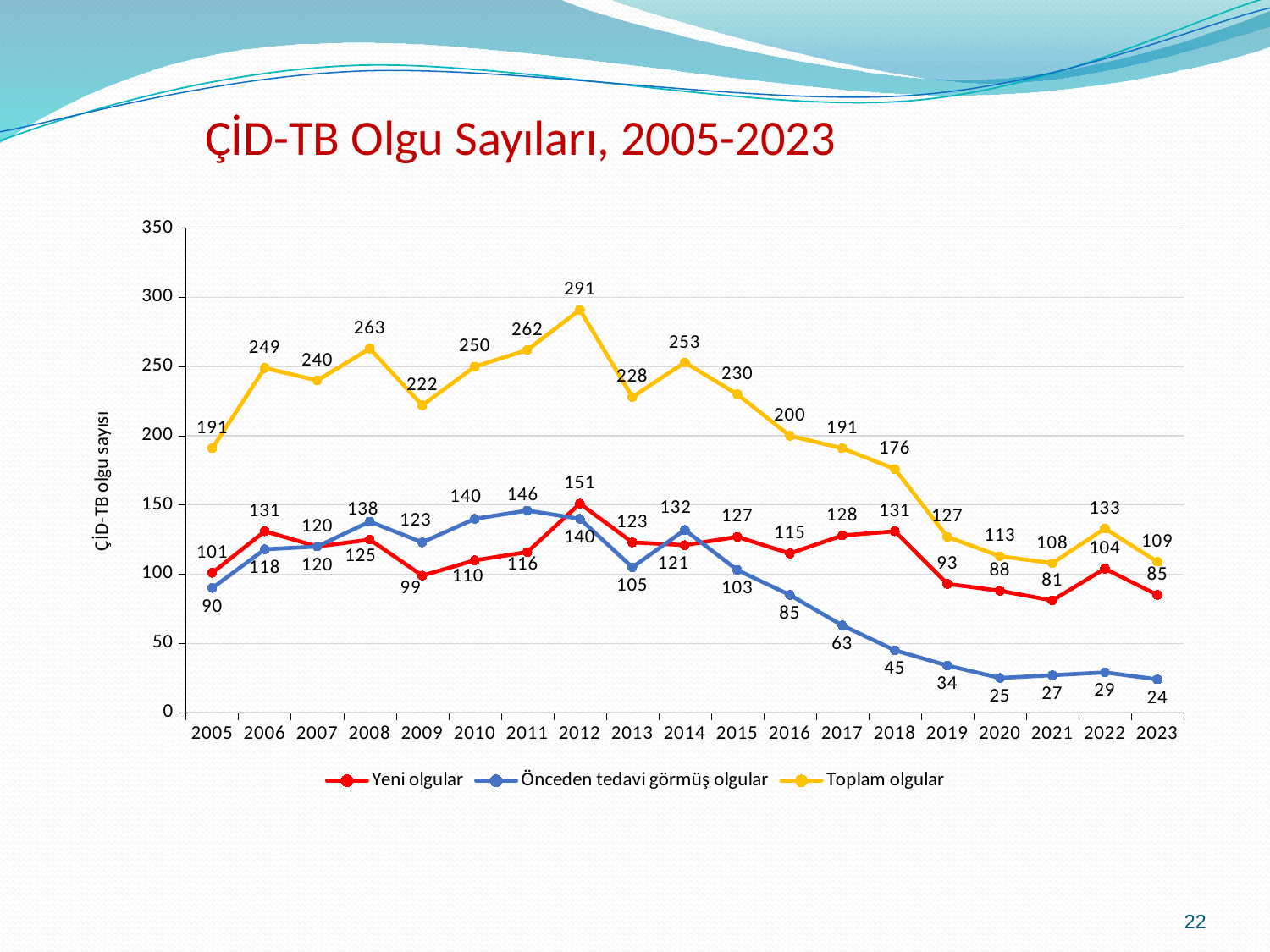
In which year is Önceden tedavi görmüş olgular lowest? 2023 Which is larger in 2011: Yeni olgular or Önceden tedavi görmüş olgular? Önceden tedavi görmüş olgular What type of chart is shown on the slide? line chart In which year is Toplam olgular highest? 2012 What is the title of the chart? ÇİD-TB Olgu Sayıları, 2005-2023 What is the value of Toplam olgular in 2012? 291 How many years are shown on the x axis? 19 What is the difference between Toplam olgular in 2012 and in 2023? 182 How many series does the legend list? 3 Does Önceden tedavi görmüş olgular generally rise or fall from 2014 to 2023? fall What is the value of Önceden tedavi görmüş olgular in 2017? 63 What is the value of Yeni olgular in 2019? 93